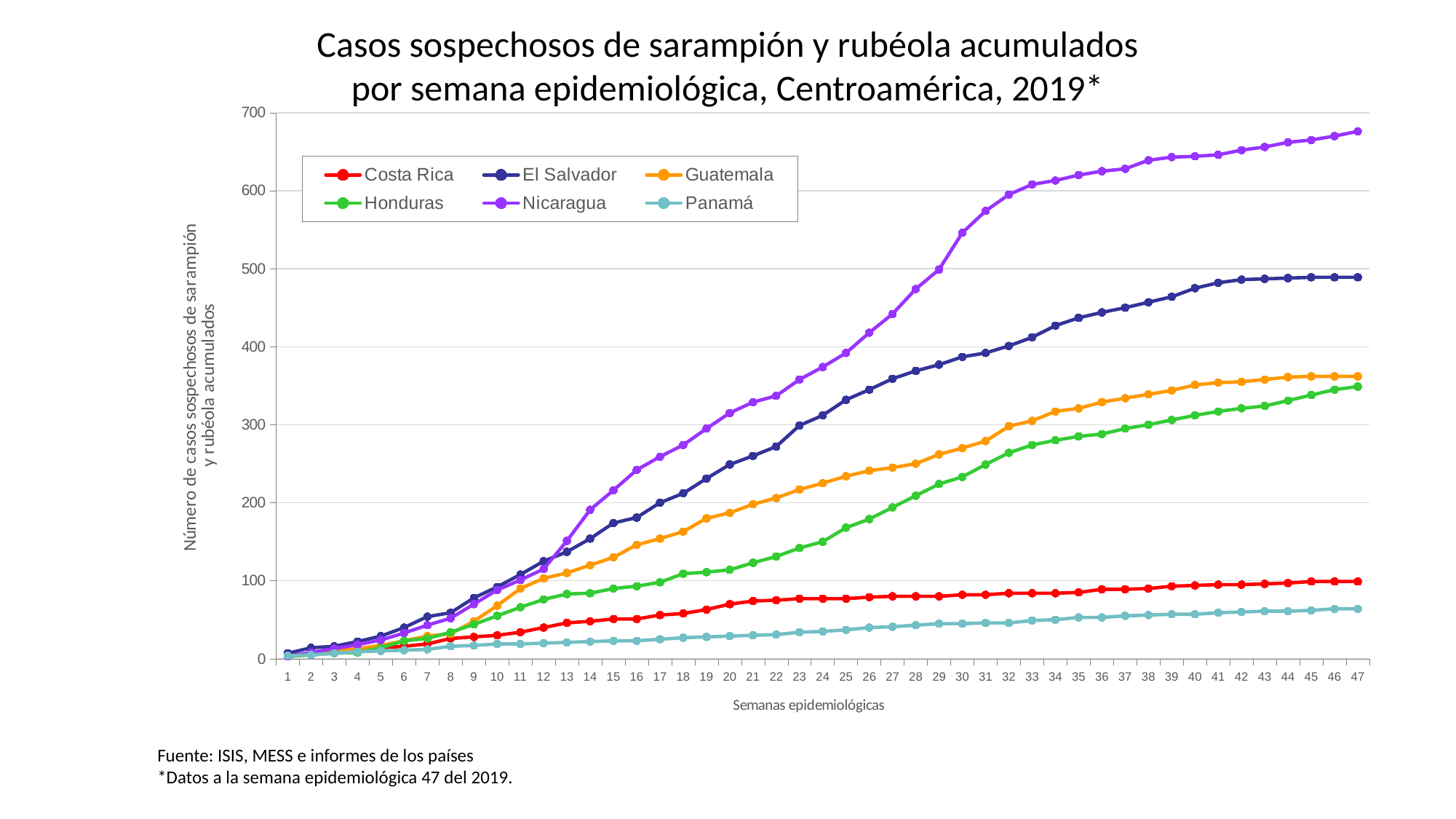
Is the value for El Salvador at week 47 greater or less than 500? less Is the value for Nicaragua at week 30 greater or less than 500? greater Which country has the lowest accumulated number of suspected cases at week 47? Panamá How many series does the legend list? 6 Do the values for El Salvador rise or fall as the weeks increase? rise At week 30, which is larger, the value for Guatemala or the value for Honduras? Guatemala What kind of chart is shown on the slide? line chart What is the title of the x axis? Semanas epidemiológicas How many epidemiological weeks are plotted along the x axis? 47 Is the value for Panamá at week 47 greater or less than 100? less Which country has the highest accumulated number of suspected cases at week 47? Nicaragua